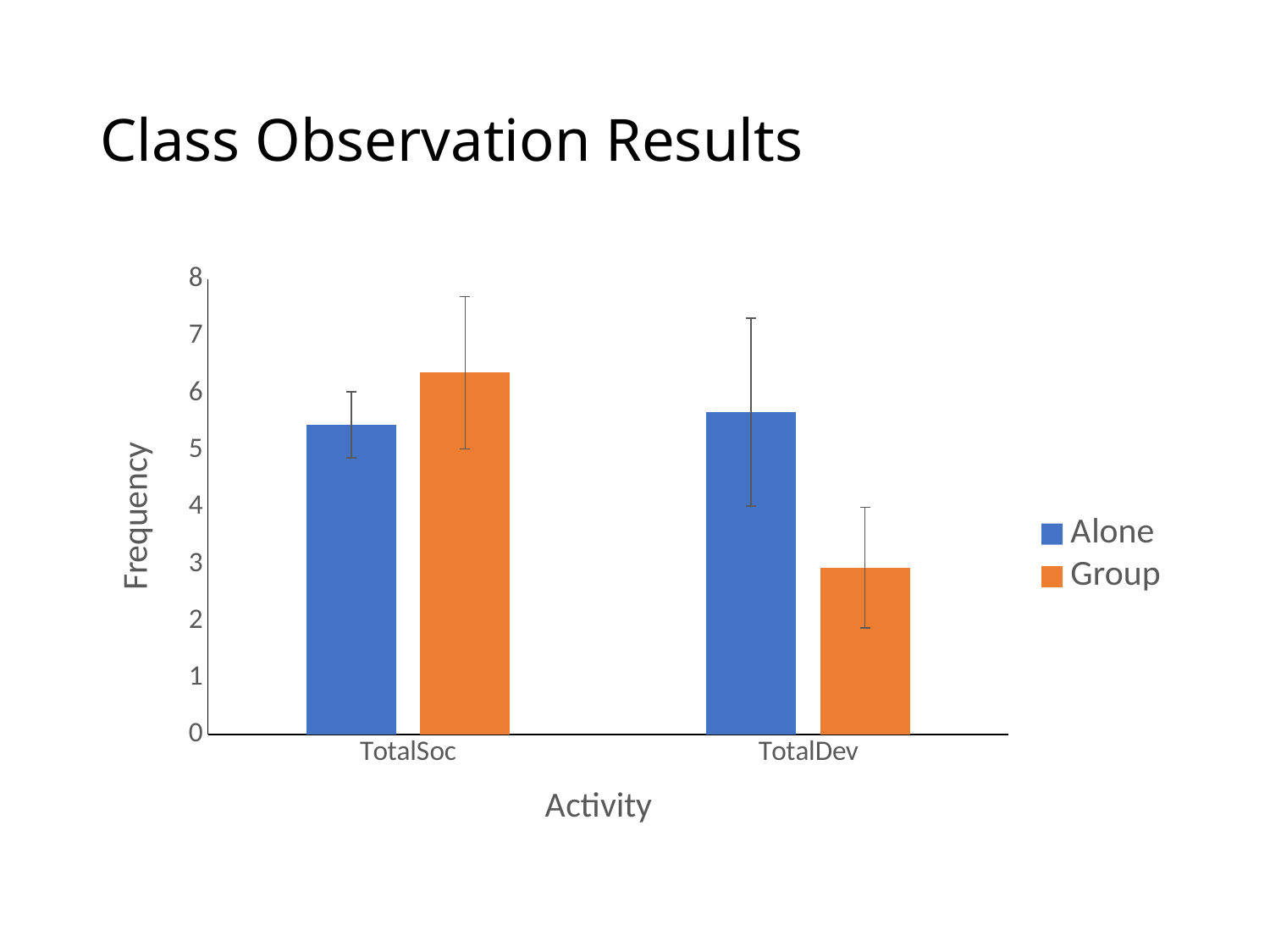
Is the Alone value for TotalSoc greater or less than 5? greater How many series does the chart's legend list? 2 How many categories are shown on the x axis of the chart? 2 Is the Alone value for TotalDev greater or less than 5? greater Which bar in the chart is the shortest? Group for TotalDev For TotalDev, which series has the larger value, Alone or Group? Alone What is the label of the y axis of the chart? Frequency For TotalSoc, which series has the larger value, Alone or Group? Group What kind of chart is shown on the slide? bar chart Which bar in the chart is the tallest? Group for TotalSoc Is the Group value for TotalDev greater or less than 4? less What is the title of the chart on the slide? Class Observation Results